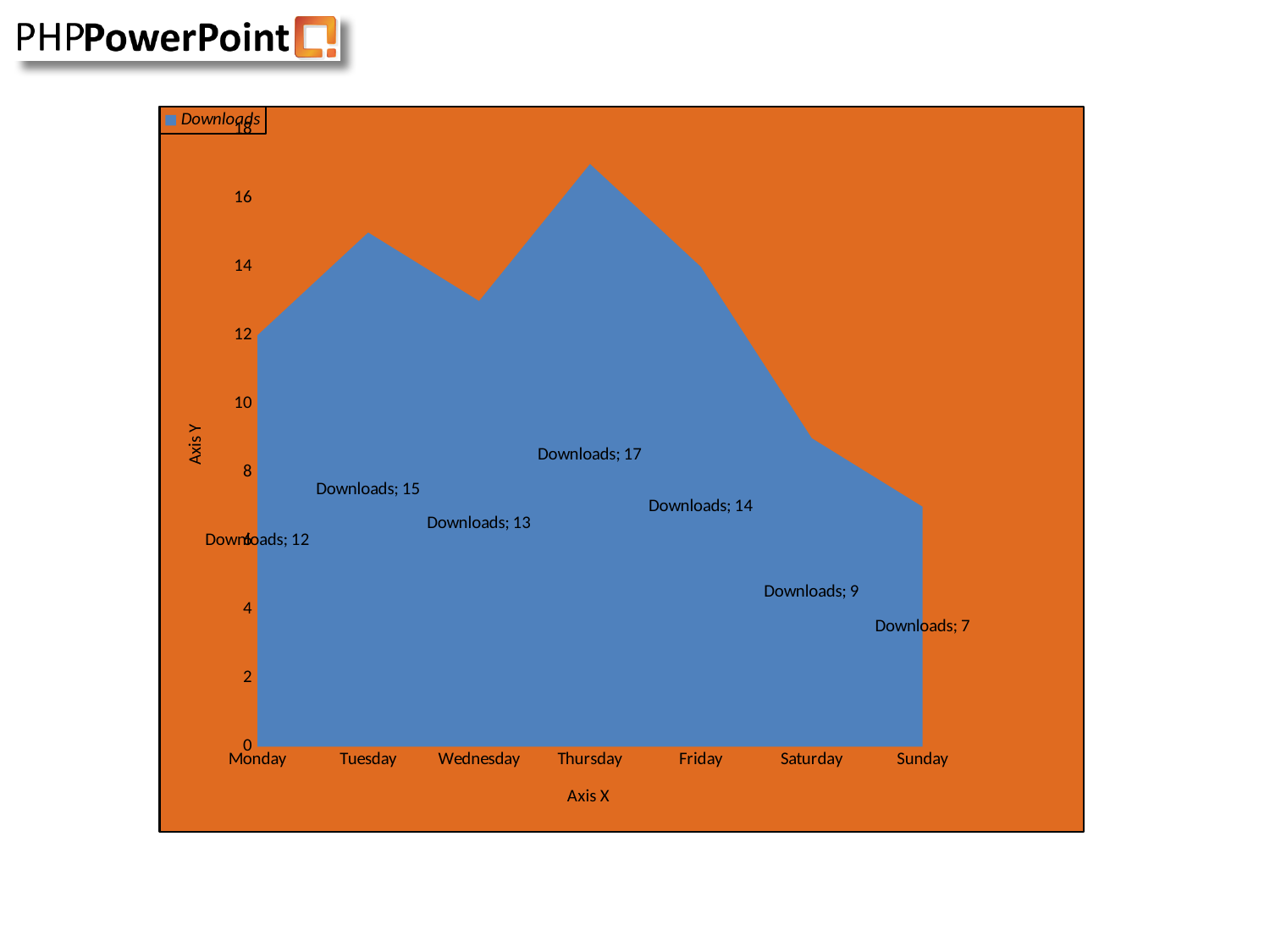
What is the Downloads value for Sunday? 7 How many series does the legend list? 1 What kind of chart is shown on the slide? area chart How many days are shown on the x axis? 7 Which day has the lowest Downloads value? Sunday What is the Downloads value for Thursday? 17 What is the difference between the Downloads values for Thursday and Sunday? 10 What is the Downloads value for Tuesday? 15 Is the Downloads value for Saturday greater or less than 10? less Which has a larger Downloads value, Tuesday or Friday? Tuesday Which day has the highest Downloads value? Thursday What is the title of the vertical axis? Axis Y